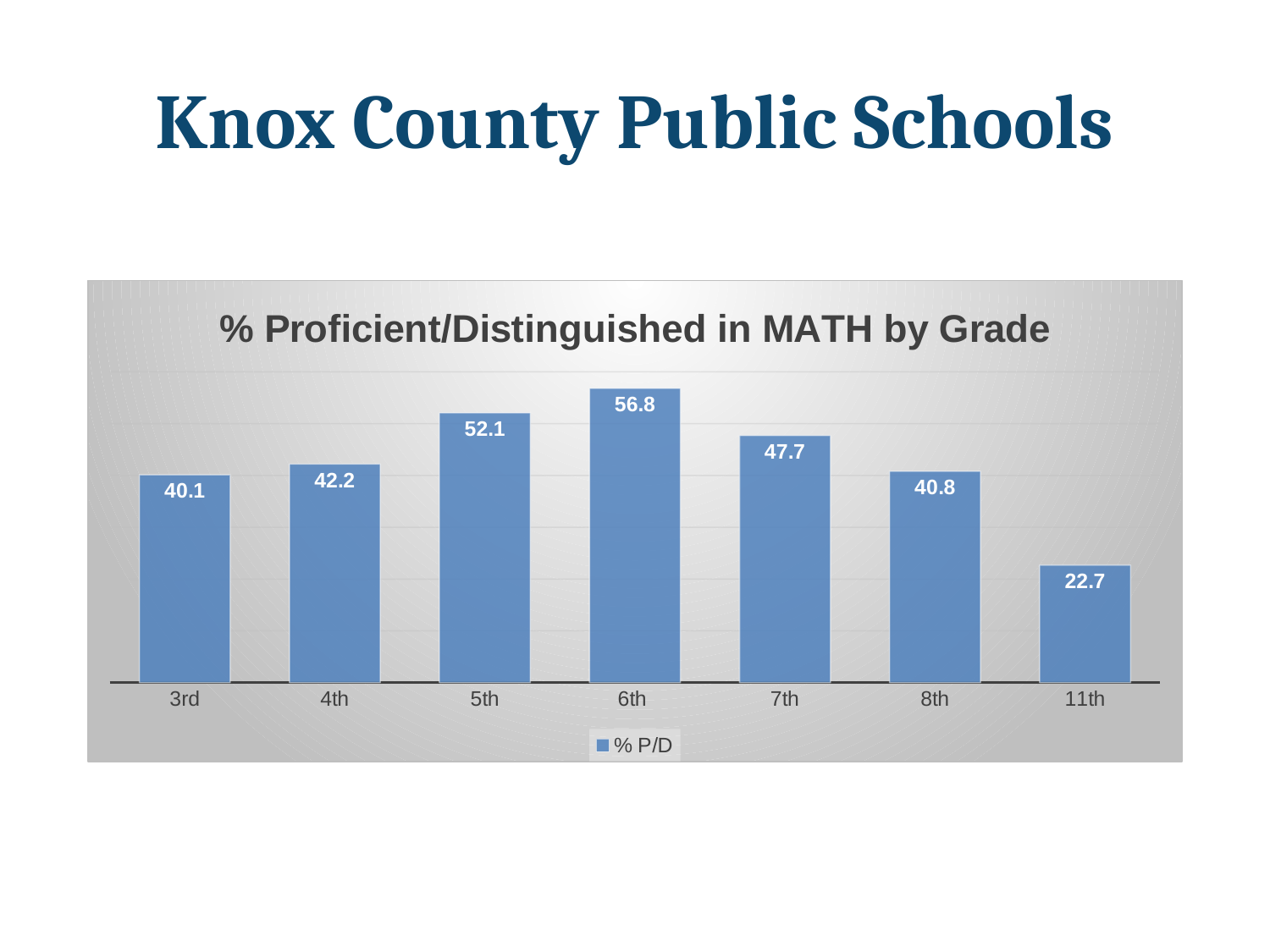
What is the % P/D value for 11th grade? 22.7 How many grades are shown on the chart? 7 Which has a higher % P/D value, 7th grade or 8th grade? 7th Which grade has the highest % Proficient/Distinguished in MATH? 6th What is the % P/D value for 4th grade? 42.2 What is the difference between the 5th grade and 3rd grade values? 12.0 What is the % P/D value for 6th grade? 56.8 How many series does the legend list? 1 What is the difference between the 6th grade and 11th grade values? 34.1 What is the title of the chart? % Proficient/Distinguished in MATH by Grade What kind of chart is shown on the slide? Bar chart Which grade has the lowest % Proficient/Distinguished in MATH? 11th